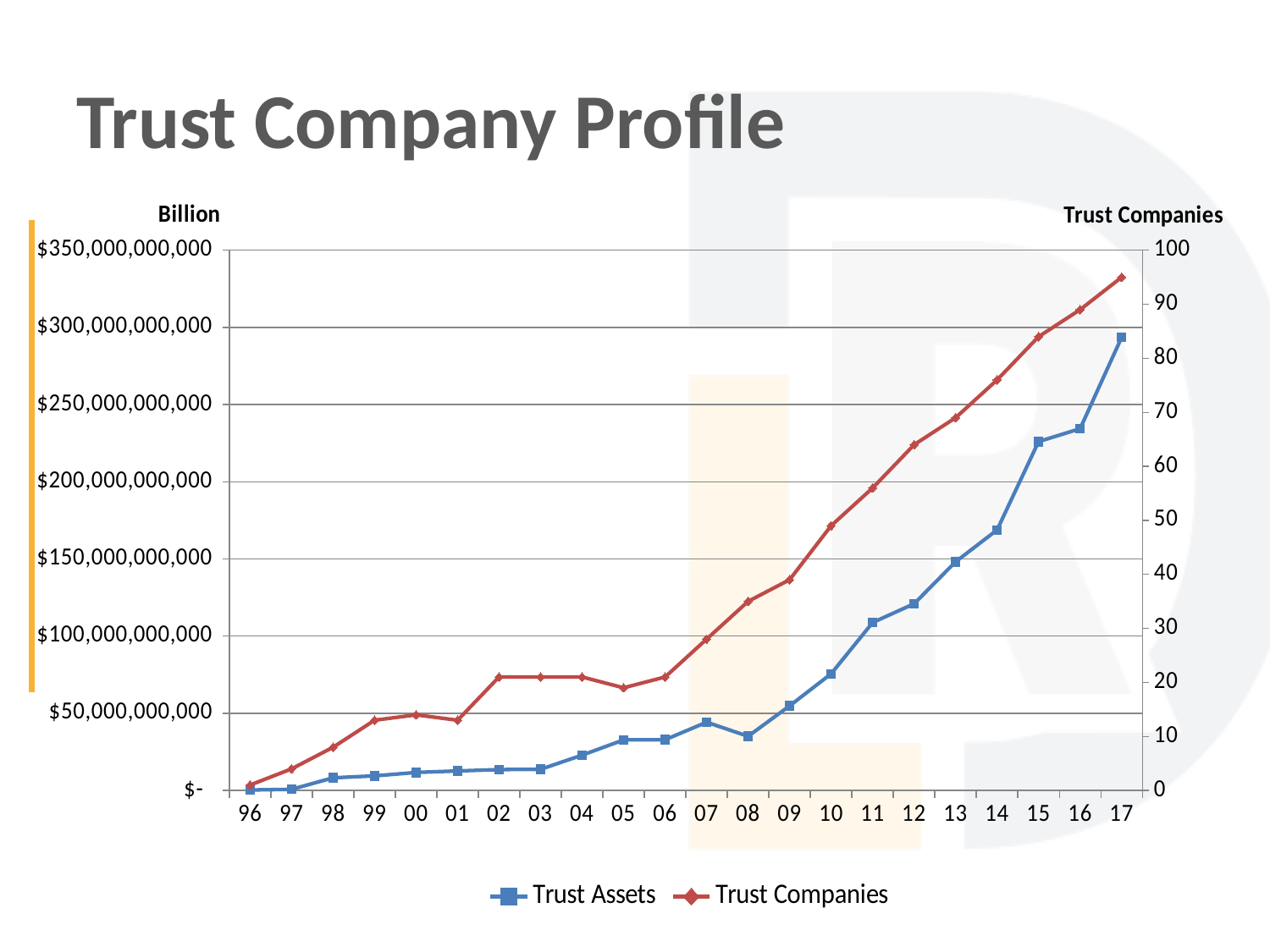
Which year has the larger Trust Assets value, 07 or 08? 07 How many series does the legend list? 2 In which year is the Trust Assets value highest? 17 Do the Trust Companies values generally rise or fall from 96 to 17? Rise How many years are plotted along the x axis? 22 What kind of chart is shown on the slide? Line chart Is the Trust Assets value for 07 greater or less than $50,000,000,000? less Is the Trust Companies value for 17 greater or less than 90? greater Is the Trust Assets value for 15 greater or less than $200,000,000,000? greater What is the title of the chart's right-hand axis? Trust Companies In which year is the Trust Companies value lowest? 96